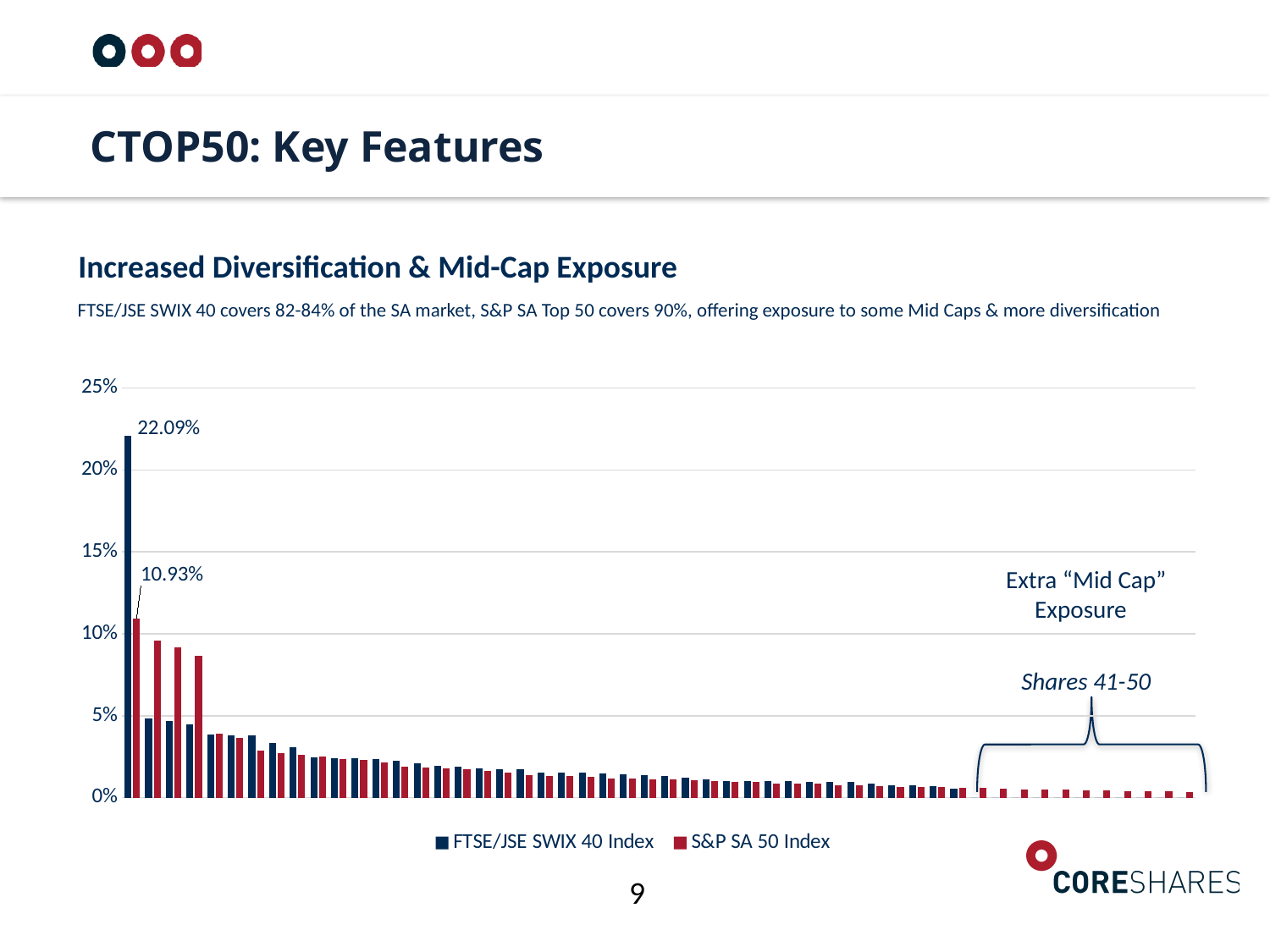
What is the value of the largest weight shown for the FTSE/JSE SWIX 40 Index? 22.09% What is the highest value shown on the chart's vertical axis? 25% What are the two series named in the chart legend? FTSE/JSE SWIX 40 Index and S&P SA 50 Index Which series is larger for the first (leftmost) pair of bars, FTSE/JSE SWIX 40 Index or S&P SA 50 Index? FTSE/JSE SWIX 40 Index How many series does the chart legend list? 2 Which series has the tallest bar in the chart? FTSE/JSE SWIX 40 Index Is the second-tallest S&P SA 50 Index bar greater or less than 10%? less What is the difference between the largest FTSE/JSE SWIX 40 Index weight (22.09%) and the largest S&P SA 50 Index weight (10.93%)? 11.16% What kind of chart is shown on the slide? Bar chart Do the bar values rise or fall moving from left to right along the x axis? Fall What is the value of the largest weight shown for the S&P SA 50 Index? 10.93% Is the tallest bar in the chart greater or less than 20%? greater